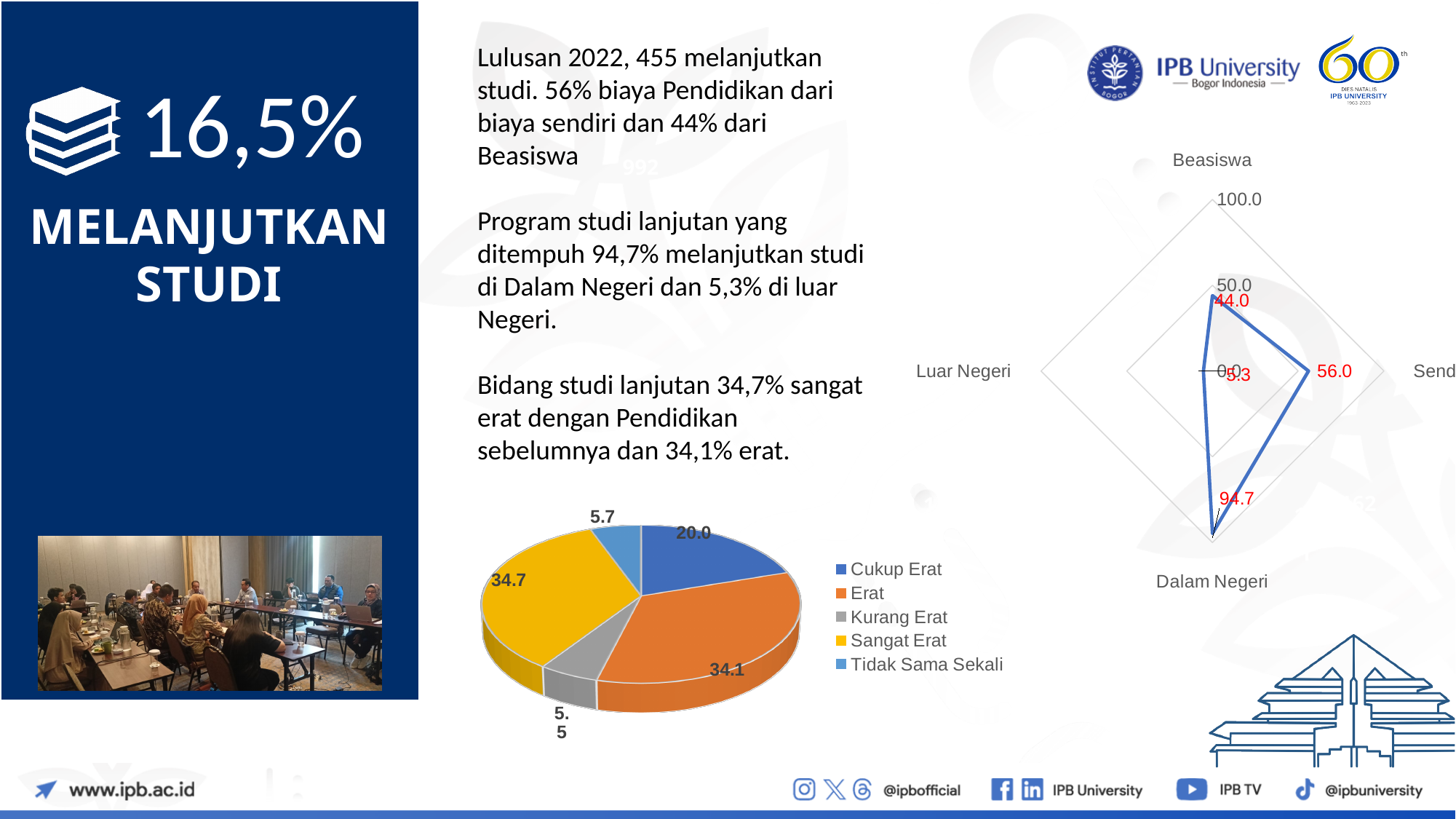
In the pie chart, which category has the largest value? Sangat Erat In the pie chart, what is the difference between the values for Sangat Erat and Cukup Erat? 14.7 In the pie chart, what is the value for Cukup Erat? 20.0 In the pie chart, what is the value for Erat? 34.1 In the radar chart on the right, what is the value for Dalam Negeri? 94.7 In the radar chart on the right, which is larger, the value for Dalam Negeri or the value for Luar Negeri? Dalam Negeri In the radar chart on the right, what is the value for Beasiswa? 44.0 What kind of chart is the chart at the bottom centre of the slide? pie chart How many entries does the legend of the pie chart list? 5 In the pie chart, what is the value for Sangat Erat? 34.7 In the pie chart, which category has the smallest value? Kurang Erat In the pie chart, what is the value for Kurang Erat? 5.5